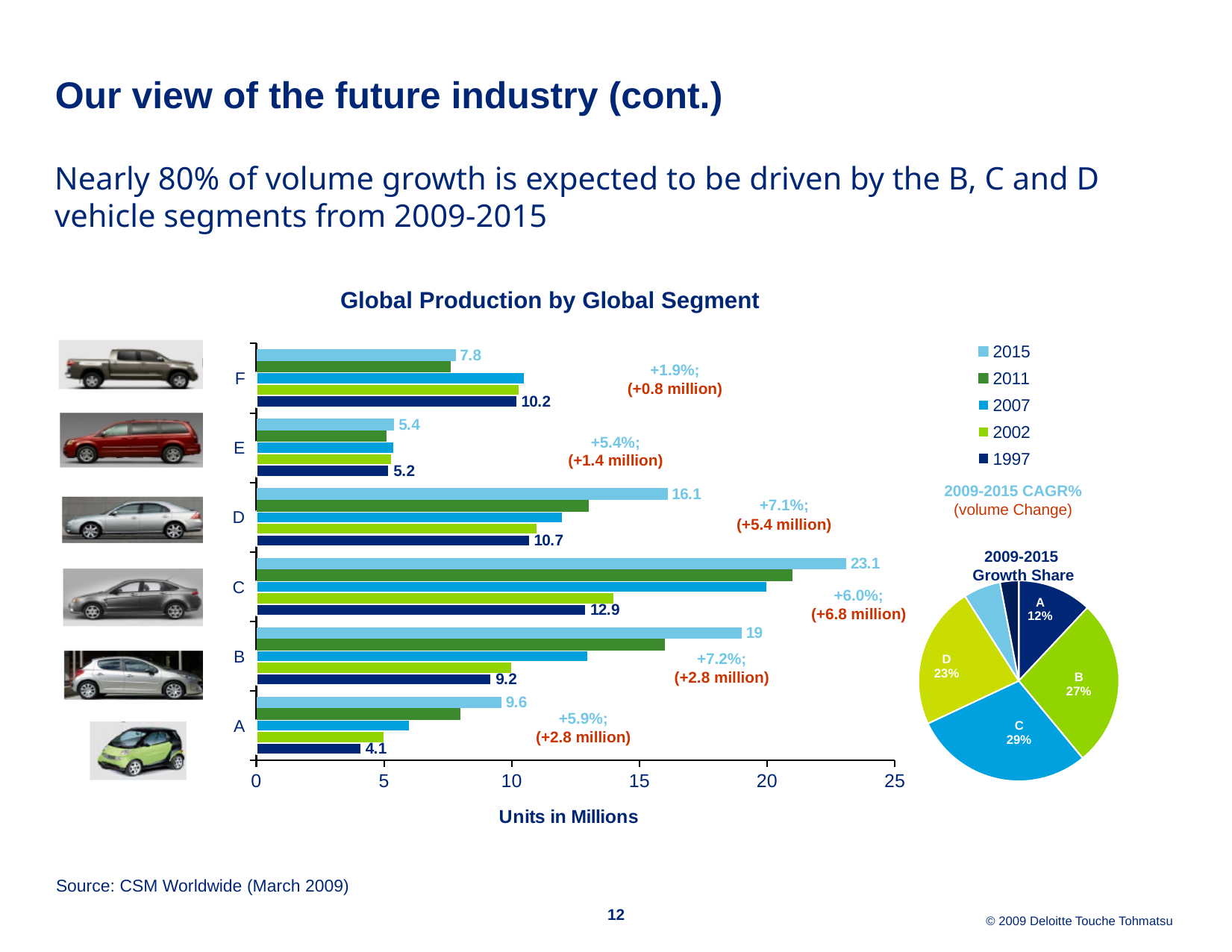
In the Global Production by Global Segment chart, which segment has the highest 2015 value? C What kind of chart is the Global Production by Global Segment chart? Bar chart In the 2009-2015 Growth Share pie chart, which is larger: the share for segment B or the share for segment D? B In the Global Production by Global Segment chart, what is the difference between the 2015 and 1997 values for segment B? 9.8 In the Global Production by Global Segment chart, what is the 2015 value for segment F? 7.8 In the Global Production by Global Segment chart, is the 2007 value for segment C greater or less than 15? greater In the 2009-2015 Growth Share pie chart, what share does segment C have? 29% In the Global Production by Global Segment chart, what is the 1997 value for segment A? 4.1 In the Global Production by Global Segment chart, what is the 2015 value for segment C? 23.1 How many series does the legend of the Global Production by Global Segment chart list? 5 In the Global Production by Global Segment chart, which is larger: the 2015 value for segment D or the 2015 value for segment A? 2015 value for segment D In the Global Production by Global Segment chart, which segment has the lowest 1997 value? A